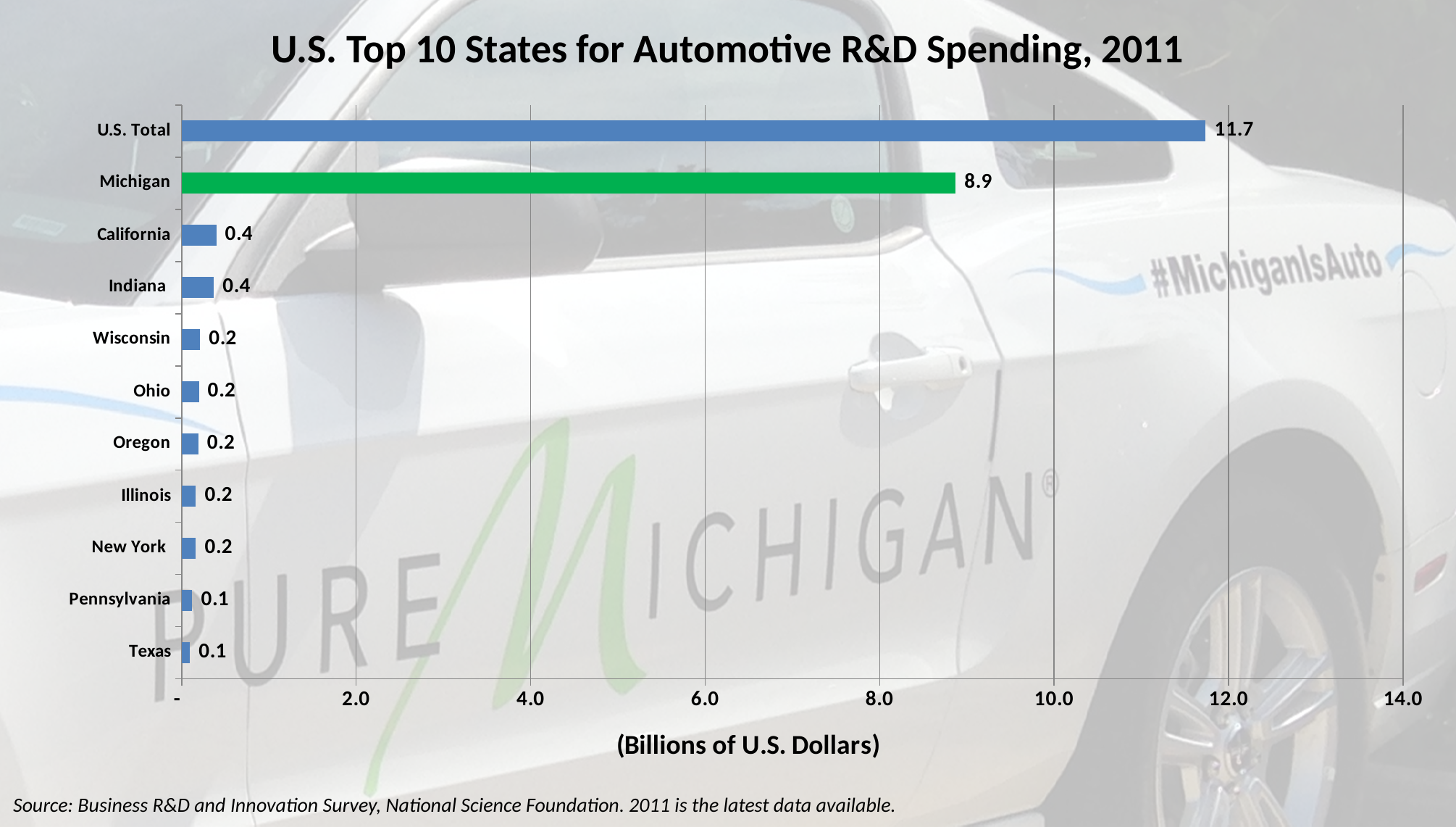
How many categories are shown on the chart? 11 What is the title of the chart? U.S. Top 10 States for Automotive R&D Spending, 2011 What is the value for California? 0.4 Is the value for Michigan greater or less than 10.0? less Which is larger, the value for Michigan or the value for Indiana? Michigan What is the value for Michigan? 8.9 What is the difference between the U.S. Total and Michigan values? 2.8 Which category has the highest value? U.S. Total What is the value for U.S. Total? 11.7 What kind of chart is this? bar chart Which state has the highest value? Michigan What is the value for Pennsylvania? 0.1